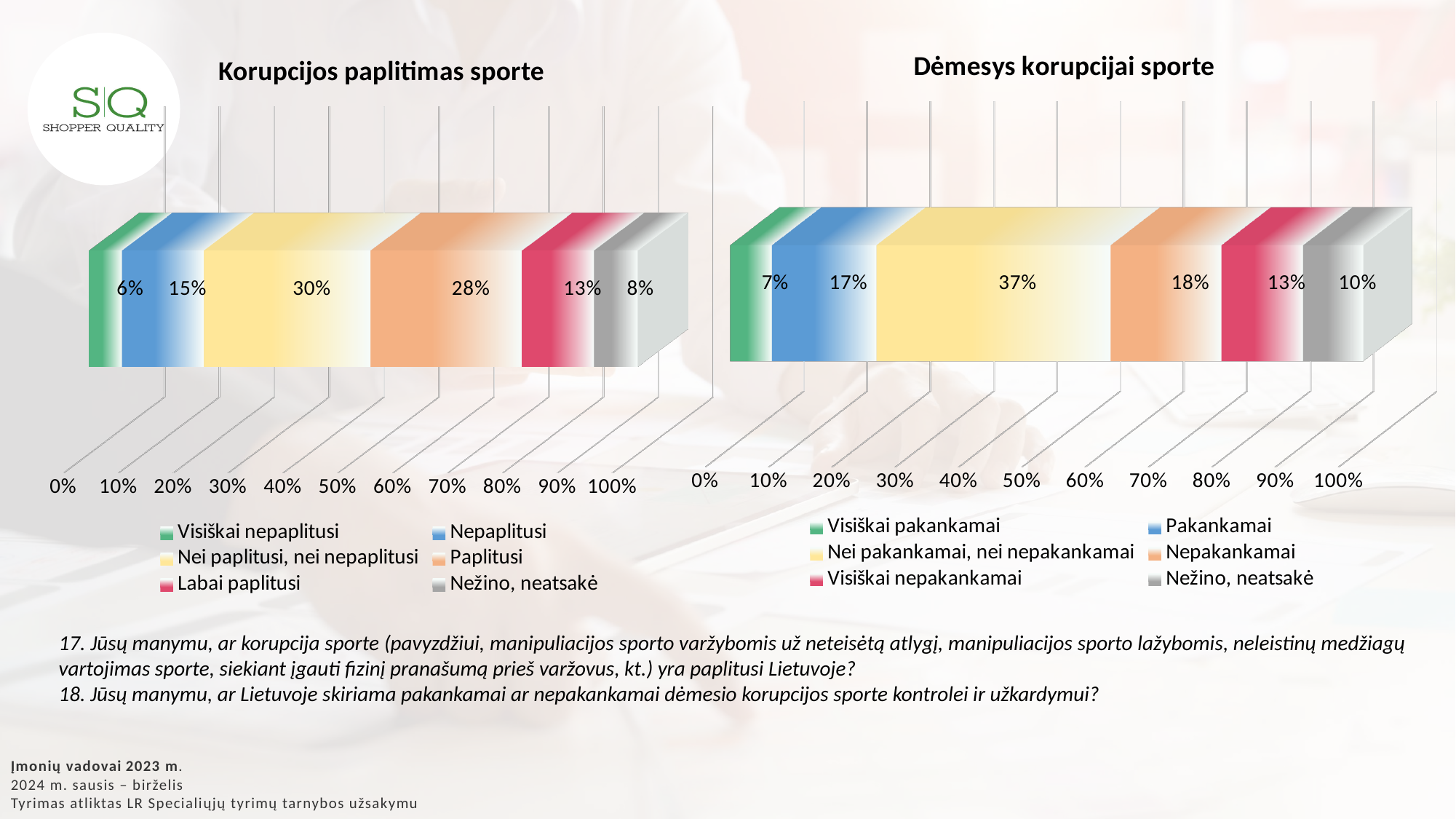
How many series does the legend of the chart titled "Korupcijos paplitimas sporte" list? 6 In the chart titled "Korupcijos paplitimas sporte", what is the value for "Nei paplitusi, nei nepaplitusi"? 30% In the chart titled "Dėmesys korupcijai sporte", which category has the largest value? Nei pakankamai, nei nepakankamai In the chart titled "Dėmesys korupcijai sporte", which is larger: "Pakankamai" or "Nepakankamai"? Nepakankamai In the chart titled "Korupcijos paplitimas sporte", what is the total of the stacked bar? 100% In the chart titled "Dėmesys korupcijai sporte", what is the difference between "Nei pakankamai, nei nepakankamai" and "Visiškai nepakankamai"? 24% In the chart titled "Korupcijos paplitimas sporte", what is the value for "Paplitusi"? 28% What kind of chart is the chart titled "Dėmesys korupcijai sporte"? Stacked bar chart In the chart titled "Dėmesys korupcijai sporte", what is the value for "Nežino, neatsakė"? 10% In the chart titled "Dėmesys korupcijai sporte", what is the value for "Nei pakankamai, nei nepakankamai"? 37% In the chart titled "Korupcijos paplitimas sporte", which category has the smallest value? Visiškai nepaplitusi In the chart titled "Korupcijos paplitimas sporte", what is the difference between "Paplitusi" and "Nepaplitusi"? 13%